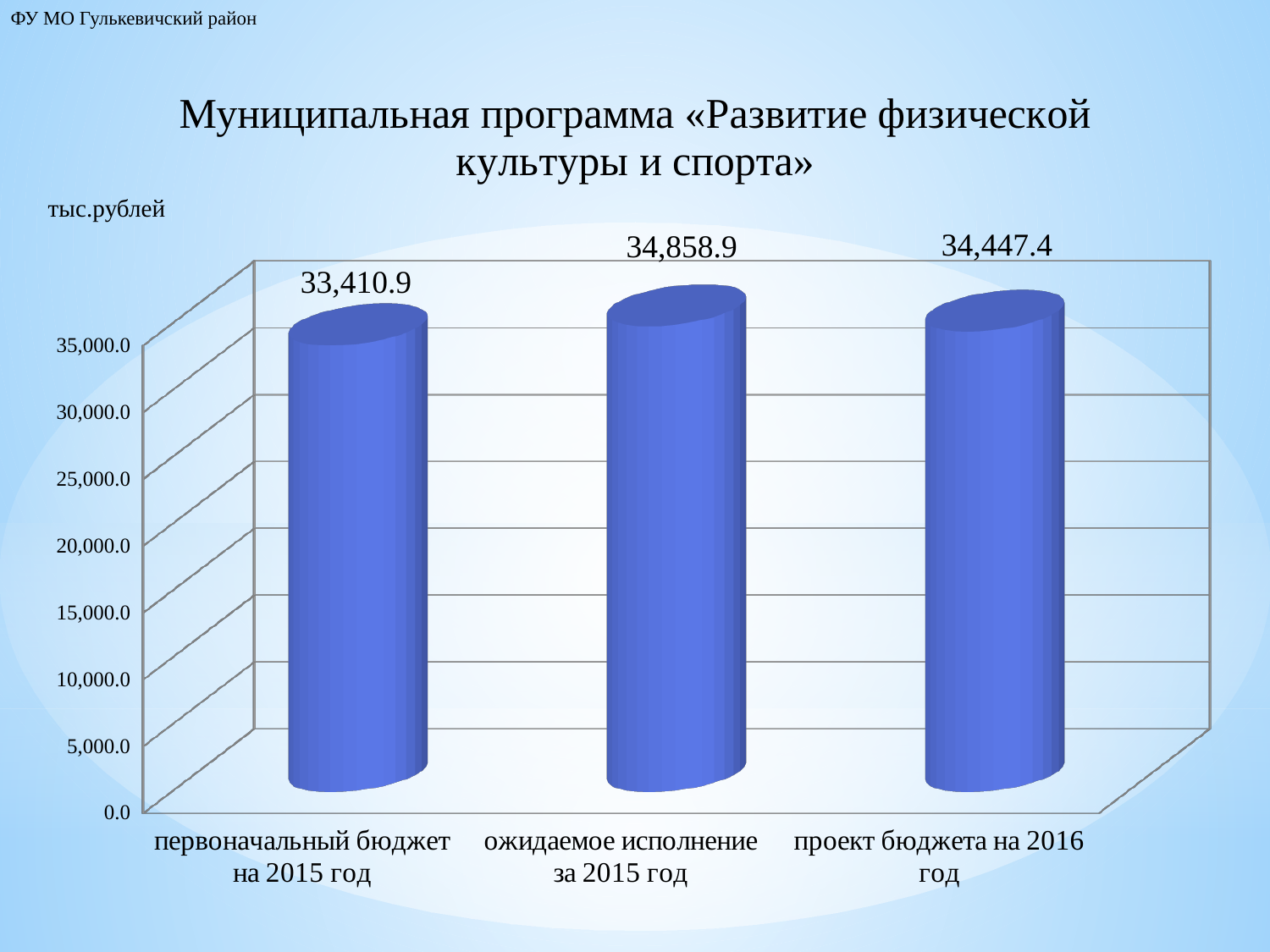
Which is larger: «проект бюджета на 2016 год» or «первоначальный бюджет на 2015 год»? проект бюджета на 2016 год What is the difference between «ожидаемое исполнение за 2015 год» and «проект бюджета на 2016 год»? 411.5 What is the value for «проект бюджета на 2016 год»? 34,447.4 What is the difference between «ожидаемое исполнение за 2015 год» and «первоначальный бюджет на 2015 год»? 1,448.0 What kind of chart is shown on the slide? bar chart Which category has the lowest value? первоначальный бюджет на 2015 год Is the value for «первоначальный бюджет на 2015 год» greater or less than 30,000.0? greater What unit of measurement is indicated above the chart? тыс.рублей What is the value for «первоначальный бюджет на 2015 год»? 33,410.9 How many categories are shown in the chart? 3 Which category has the highest value? ожидаемое исполнение за 2015 год What is the value for «ожидаемое исполнение за 2015 год»? 34,858.9